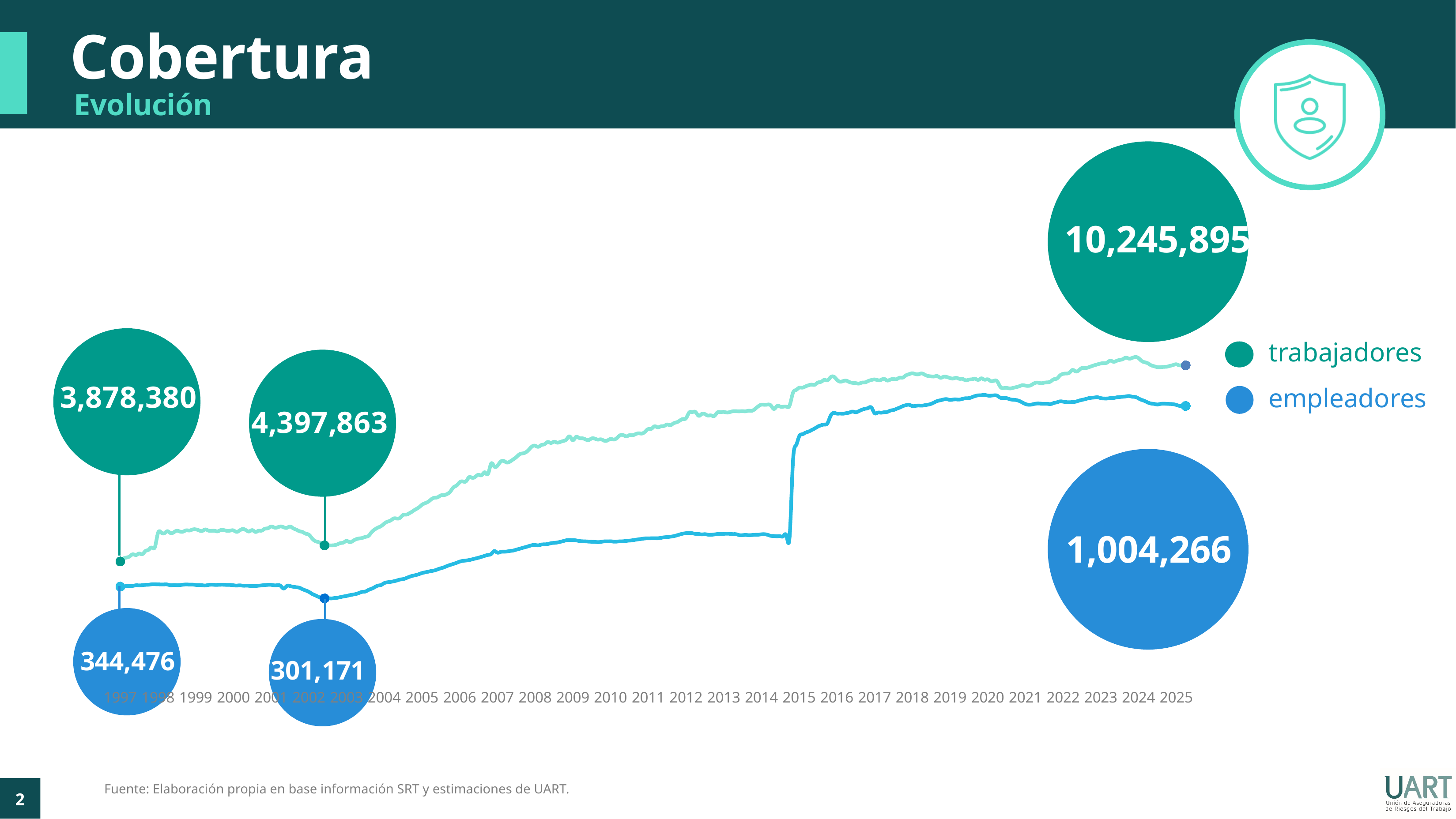
What is the value of empleadores labelled at 2002? 301,171 What is the value of trabajadores labelled at 2002? 4,397,863 What is the latest value of trabajadores shown at the end of the series? 10,245,895 What type of chart is shown on the slide? line chart What is the value of trabajadores at the start of the series in 1997? 3,878,380 What is the value of empleadores at the start of the series in 1997? 344,476 Do the trabajadores values generally rise or fall from 1997 to 2025? rise What are the two series named in the legend? trabajadores and empleadores By how much did trabajadores increase between 1997 and 2002? 519,483 What is the latest value of empleadores shown at the end of the series? 1,004,266 How many series does the legend list? 2 Which series has the higher values throughout the chart, trabajadores or empleadores? trabajadores